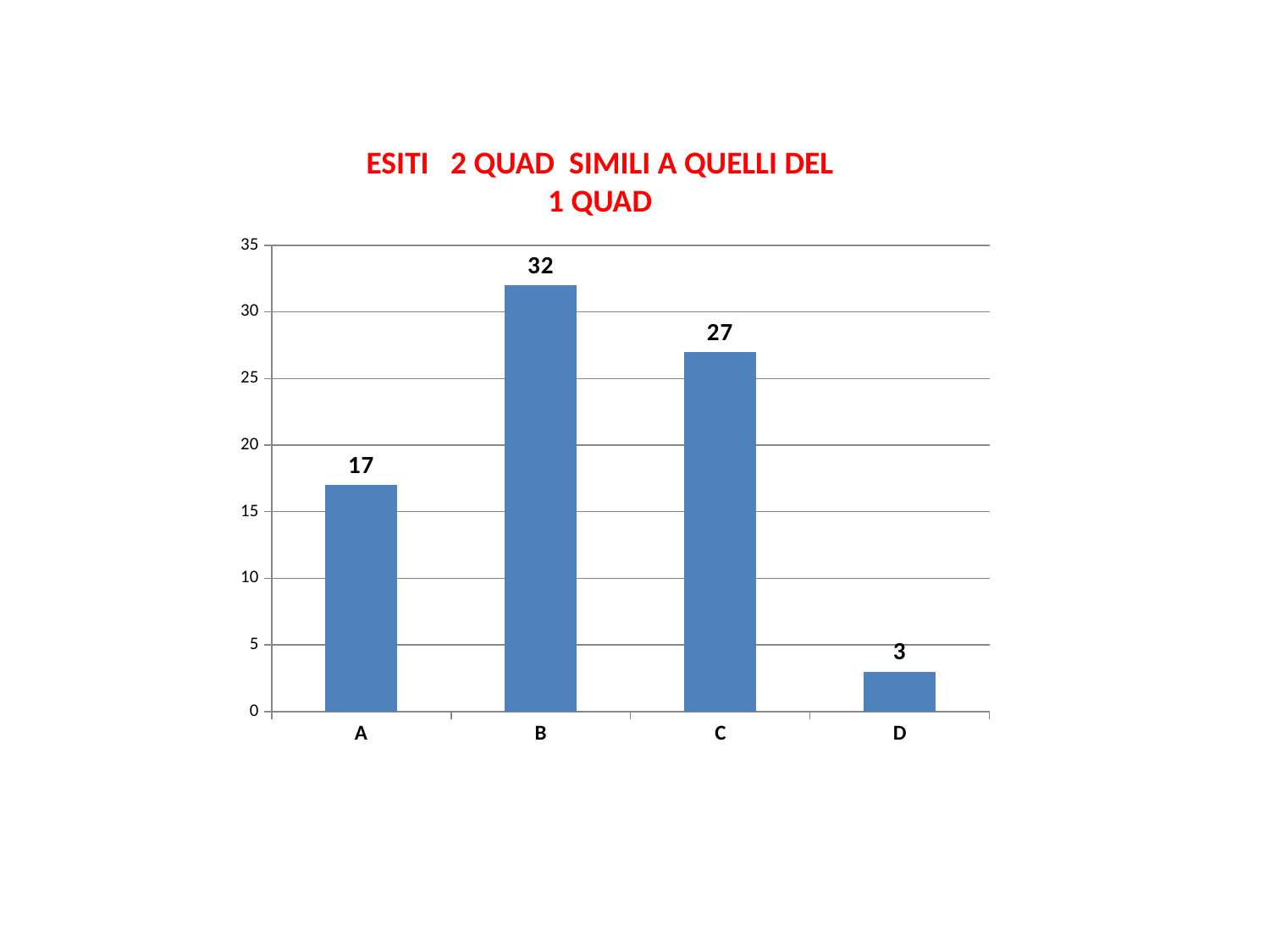
What is the value for category A? 17 What is the value for category B? 32 What is the value for category D? 3 Is the value for C greater or less than 25? greater How many categories are shown on the x axis? 4 Which category has the lowest value? D What is the difference between the values for A and D? 14 Which is larger, the value for A or the value for C? C What is the difference between the values for B and C? 5 What is the title of the chart? ESITI 2 QUAD SIMILI A QUELLI DEL 1 QUAD What kind of chart is shown on the slide? bar chart Which category has the highest value? B